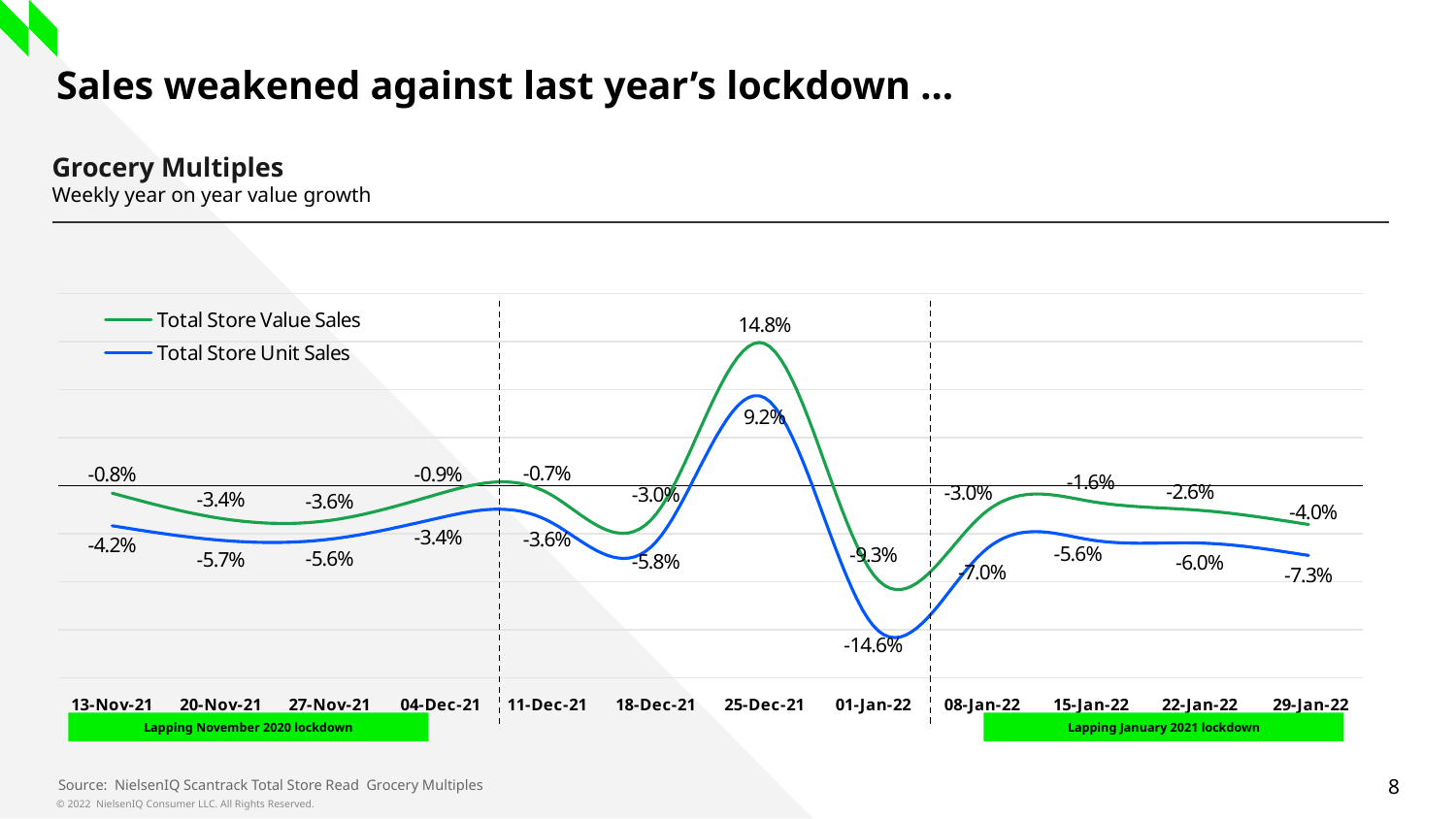
Does Total Store Value Sales growth rise or fall from 15-Jan-22 to 29-Jan-22? Fall How many series does the legend list? 2 What is the Total Store Unit Sales growth for 01-Jan-22? -14.6% On 29-Jan-22, which series has the higher growth, Total Store Value Sales or Total Store Unit Sales? Total Store Value Sales What is the difference between Total Store Value Sales and Total Store Unit Sales growth on 25-Dec-21? 5.6 percentage points What kind of chart is shown on the slide? Line chart What is the Total Store Unit Sales growth for 13-Nov-21? -4.2% How many weekly data points are shown on the x axis? 12 Which week has the lowest Total Store Unit Sales growth? 01-Jan-22 Which week has the highest Total Store Value Sales growth? 25-Dec-21 What is the Total Store Value Sales growth for 29-Jan-22? -4.0% What is the Total Store Value Sales growth for 25-Dec-21? 14.8%